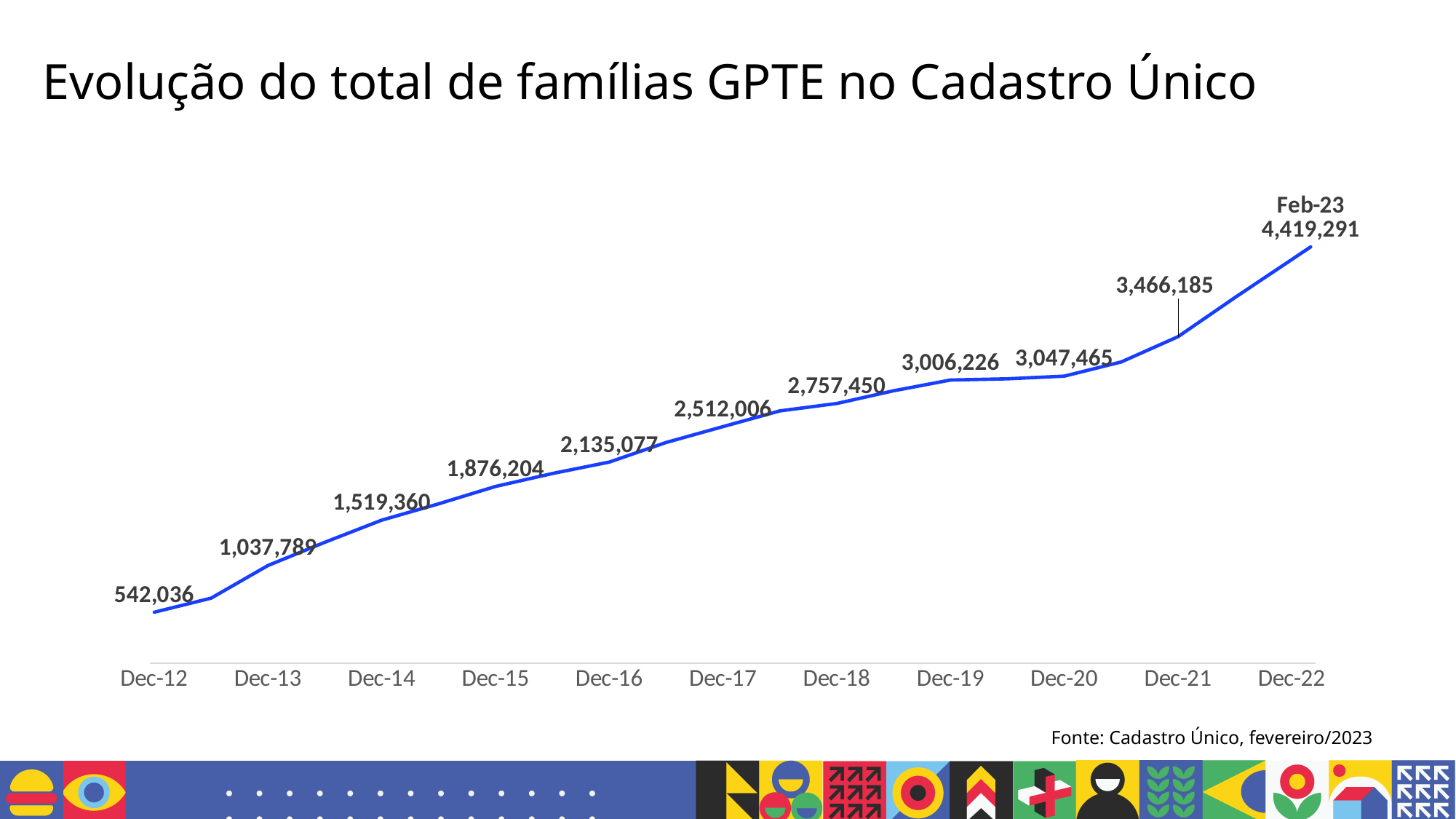
What is the title of the chart? Evolução do total de famílias GPTE no Cadastro Único What kind of chart is shown on the slide? Line chart What is the value for Dec-17? 2,512,006 What is the value labelled for Feb-23? 4,419,291 What is the value for Dec-21? 3,466,185 What is the difference between the Dec-20 value and the Dec-19 value? 41,239 What is the value for Dec-12? 542,036 Which labelled point has the highest value? Feb-23 Do the values rise or fall from Dec-12 to Feb-23? Rise What is the difference between the Feb-23 value and the Dec-12 value? 3,877,255 Which is larger, the value for Dec-19 or the value for Dec-20? Dec-20 Which labelled point has the lowest value? Dec-12